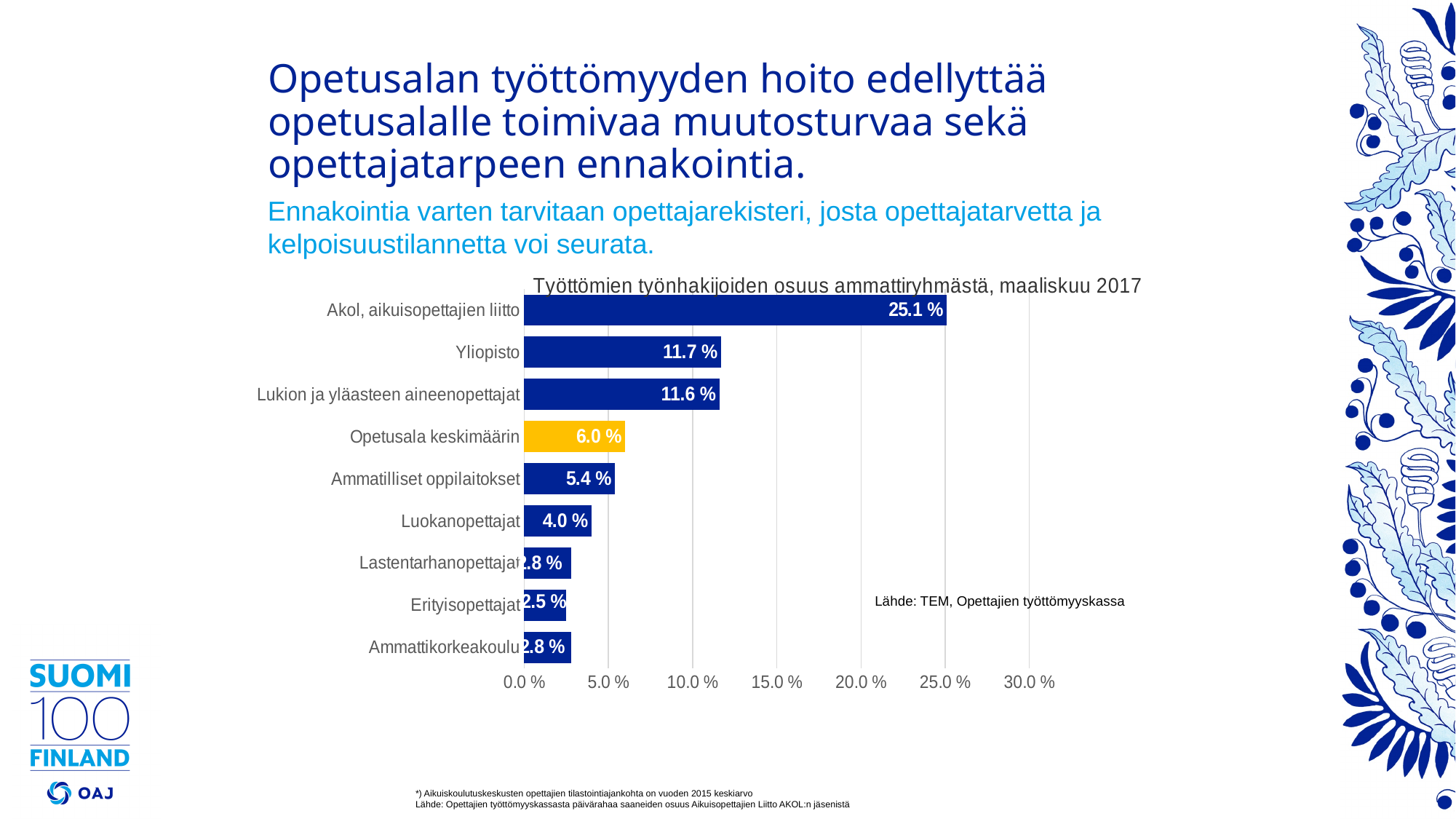
Which category has the highest value? Akol, aikuisopettajien liitto What is the value for Opetusala keskimäärin? 6.0 % What is the value for Luokanopettajat? 4.0 % How many categories are plotted in the chart? 9 What kind of chart is shown on the slide? bar chart Which category has the lowest value? Erityisopettajat What is the value for Ammatilliset oppilaitokset? 5.4 % What is the value for Akol, aikuisopettajien liitto? 25.1 % What is the title of the chart? Työttömien työnhakijoiden osuus ammattiryhmästä, maaliskuu 2017 Which bar is coloured differently (yellow) from the others? Opetusala keskimäärin What is the difference between the values for Akol, aikuisopettajien liitto and Yliopisto? 13.4 % Which is larger, the value for Luokanopettajat or the value for Lastentarhanopettajat? Luokanopettajat